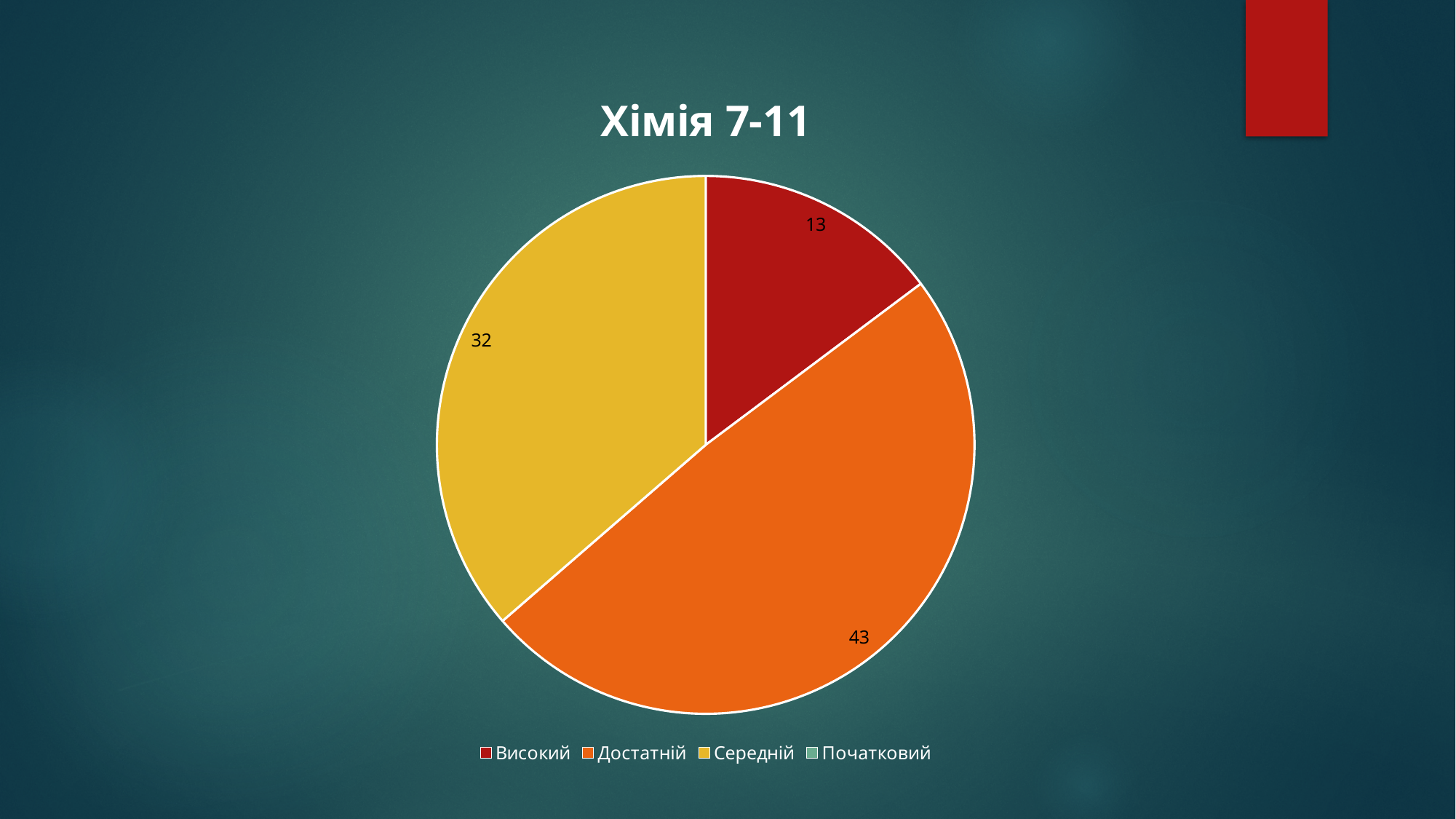
What kind of chart is shown on the slide? Pie chart What is the difference between the values for Достатній and Середній? 11 What is the difference between the values for Достатній and Високий? 30 Which labelled category has the smallest slice in the pie chart? Високий Which is larger, the value for Середній or the value for Високий? Середній What is the title of the chart? Хімія 7-11 What is the value for Достатній in the pie chart? 43 What is the value for Високий in the pie chart? 13 How many entries does the legend list? 4 What is the difference between the values for Середній and Високий? 19 What is the value for Середній in the pie chart? 32 Which category has the largest slice in the pie chart? Достатній